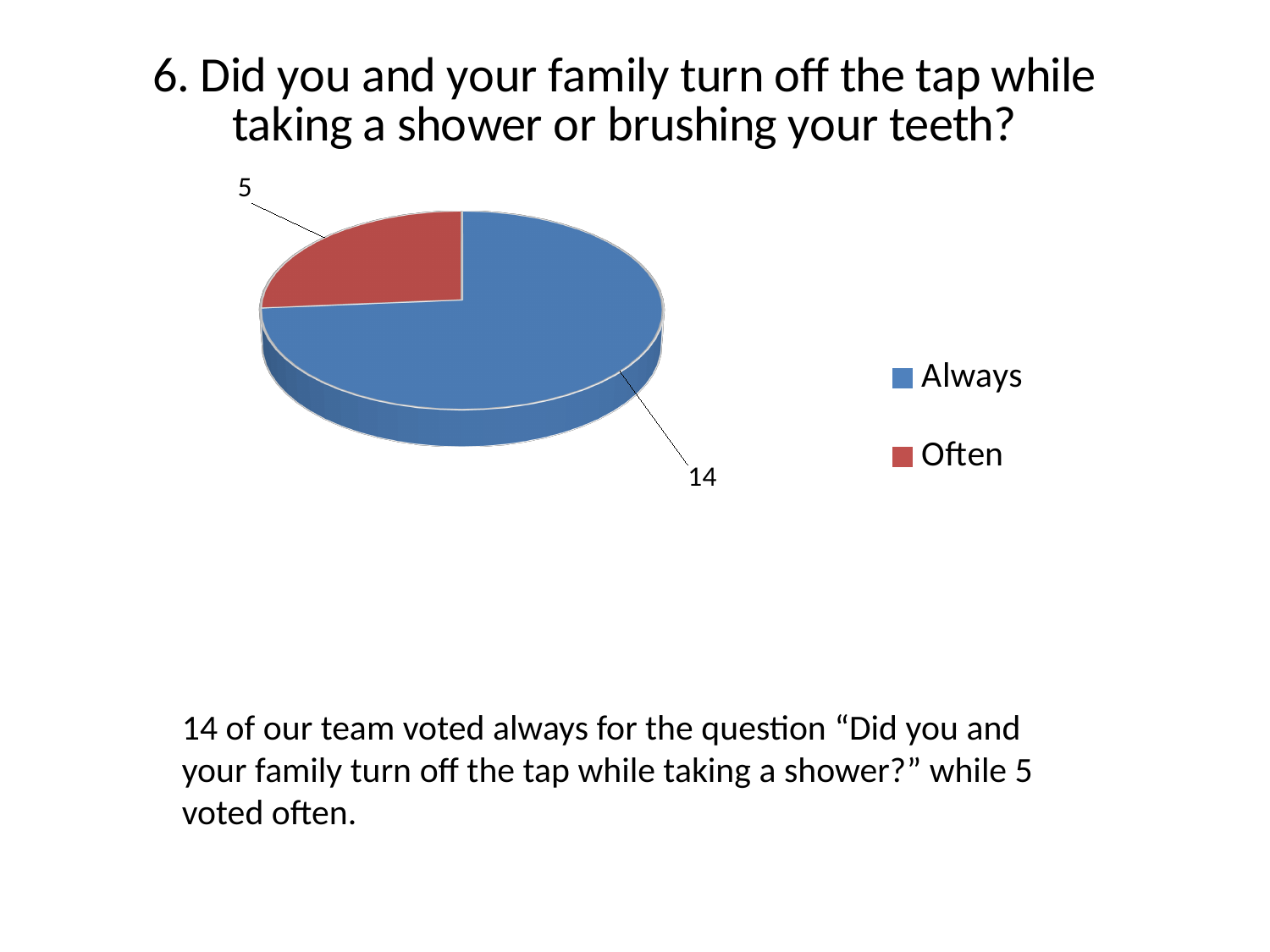
What colour is the Often slice? red How many entries does the legend list? 2 What is the total of all slices in the pie chart? 19 Which category has the smallest slice? Often Which is larger, the value for Always or the value for Often? Always How many categories does the pie chart have? 2 Which category has the largest slice? Always What colour is the Always slice? blue What is the value for Always? 14 What is the difference between the values for Always and Often? 9 What kind of chart is shown on the slide? pie chart What is the value for Often? 5